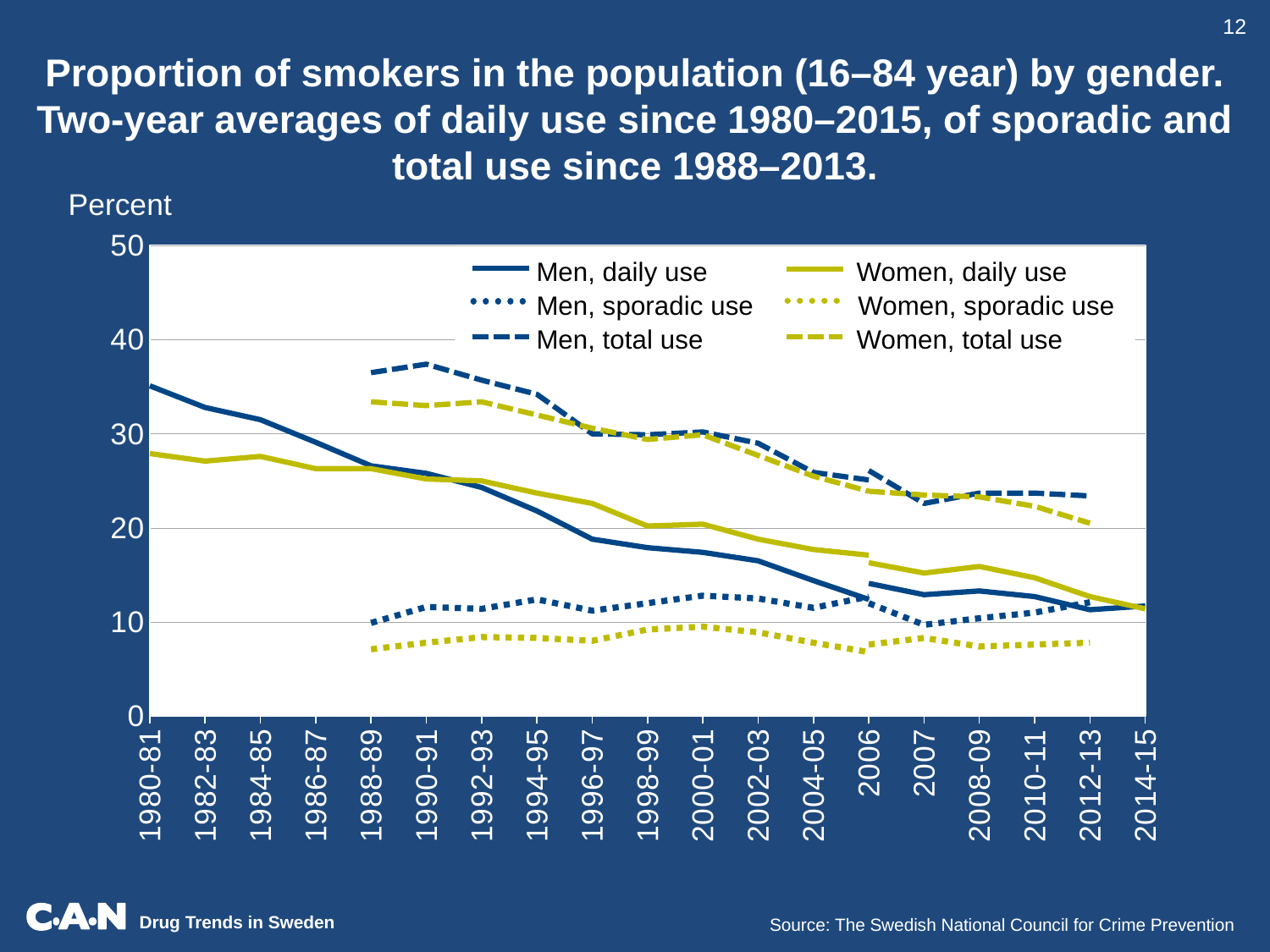
How many time periods are labelled along the x axis? 19 What unit is shown as the label of the vertical axis? Percent Does the Men, daily use line rise or fall from 1980-81 to 2014-15? Fall How many series does the legend list? 6 What kind of chart is shown on the slide? Line chart Does the Women, daily use line rise or fall from 1980-81 to 2014-15? Fall In 1980-81, which is larger: Men, daily use or Women, daily use? Men, daily use Is the value for Women, sporadic use in 2006 greater or less than 10? less Is the value for Women, daily use in 1980-81 greater or less than 30? less In 1988-89, which is larger: Men, sporadic use or Women, sporadic use? Men, sporadic use Is the value for Men, total use in 1990-91 greater or less than 30? greater